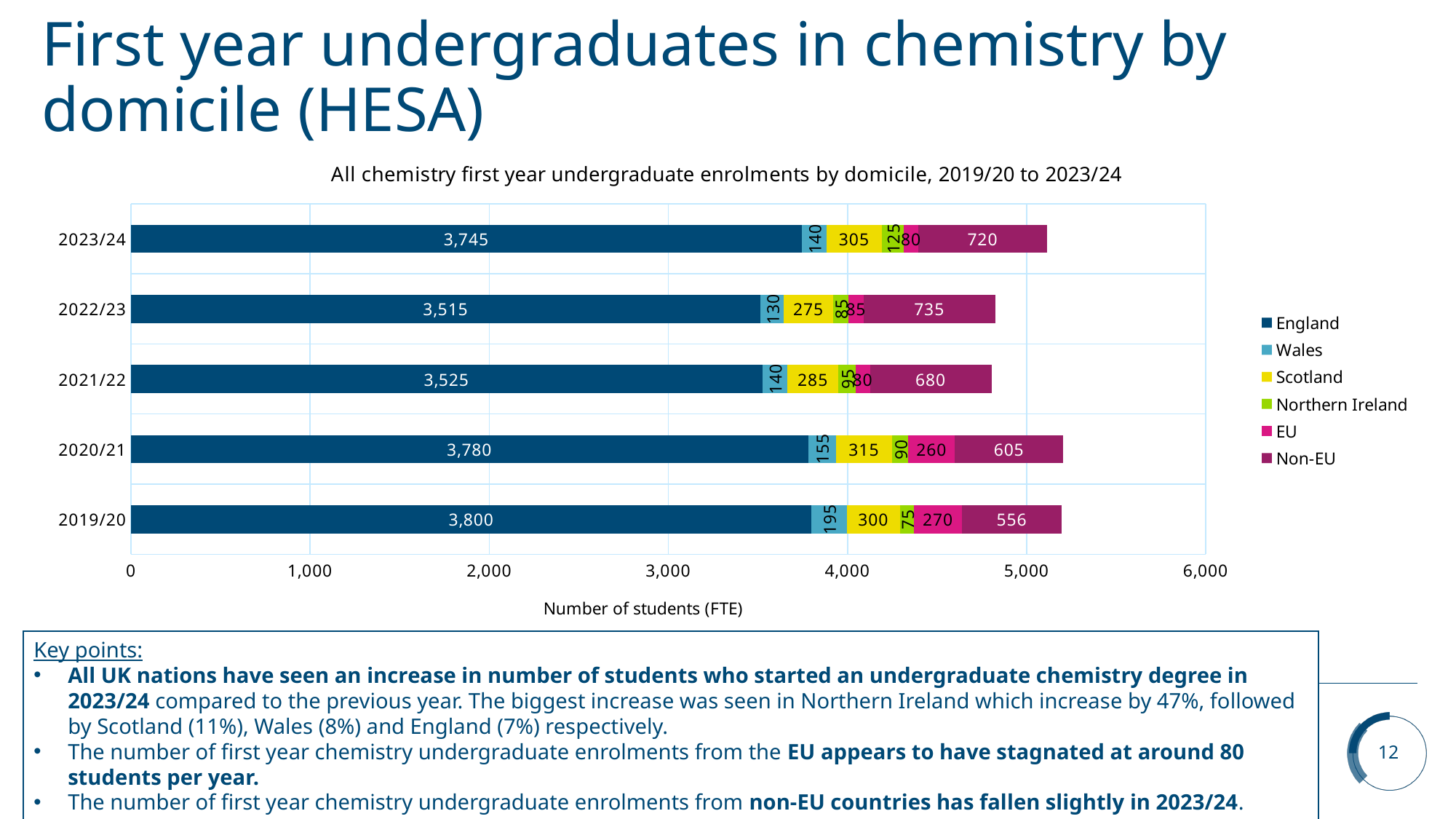
How many academic years are shown on the chart? 5 In which year is the England value highest? 2019/20 What kind of chart is shown on the slide? Stacked bar chart In which year is the England value lowest? 2022/23 What is the difference between the Non-EU values for 2022/23 and 2023/24? 15 Which year has the larger Scotland value, 2023/24 or 2020/21? 2020/21 How many Non-EU students are shown for 2022/23? 735 What is the label on the horizontal axis of the chart? Number of students (FTE) What is the total number of students for 2023/24 across all domiciles? 5,115 How many series does the legend list? 6 What is the EU value for 2020/21? 260 What is the number of England-domiciled first year chemistry undergraduates in 2023/24? 3,745